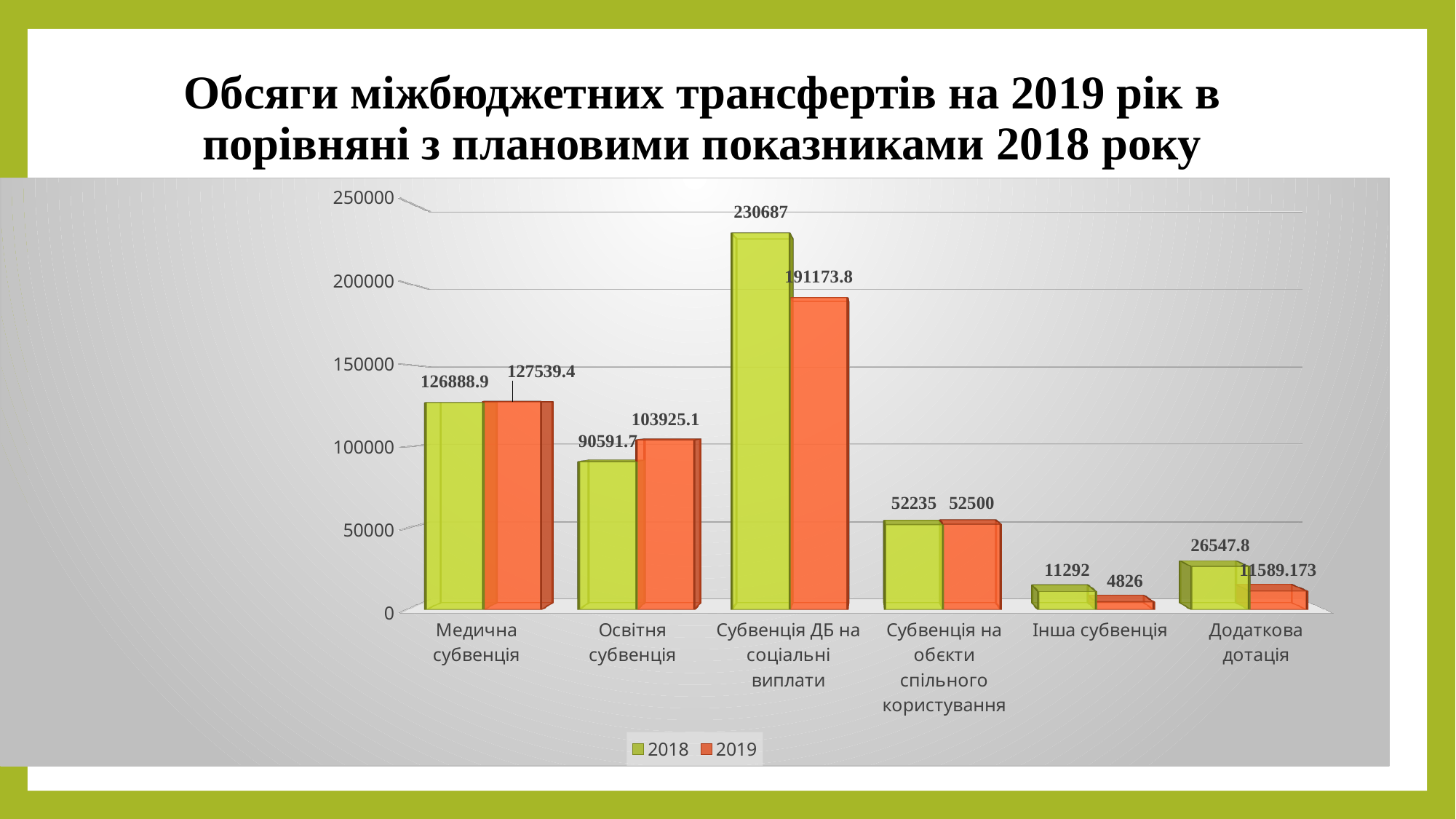
Which category has the lowest 2019 value? Інша субвенція What is the difference between the 2019 and 2018 values for Освітня субвенція? 13333.4 What is the difference between the 2018 and 2019 values for Субвенція ДБ на соціальні виплати? 39513.2 Which category has the highest 2018 value? Субвенція ДБ на соціальні виплати For Додаткова дотація, which year has the larger value, 2018 or 2019? 2018 What is the 2018 value for Медична субвенція? 126888.9 How many categories are shown on the x axis? 6 What kind of chart is shown on the slide? Bar chart What is the 2019 value for Освітня субвенція? 103925.1 What is the 2019 value for Інша субвенція? 4826 What is the 2018 value for Додаткова дотація? 26547.8 How many series does the legend list? 2